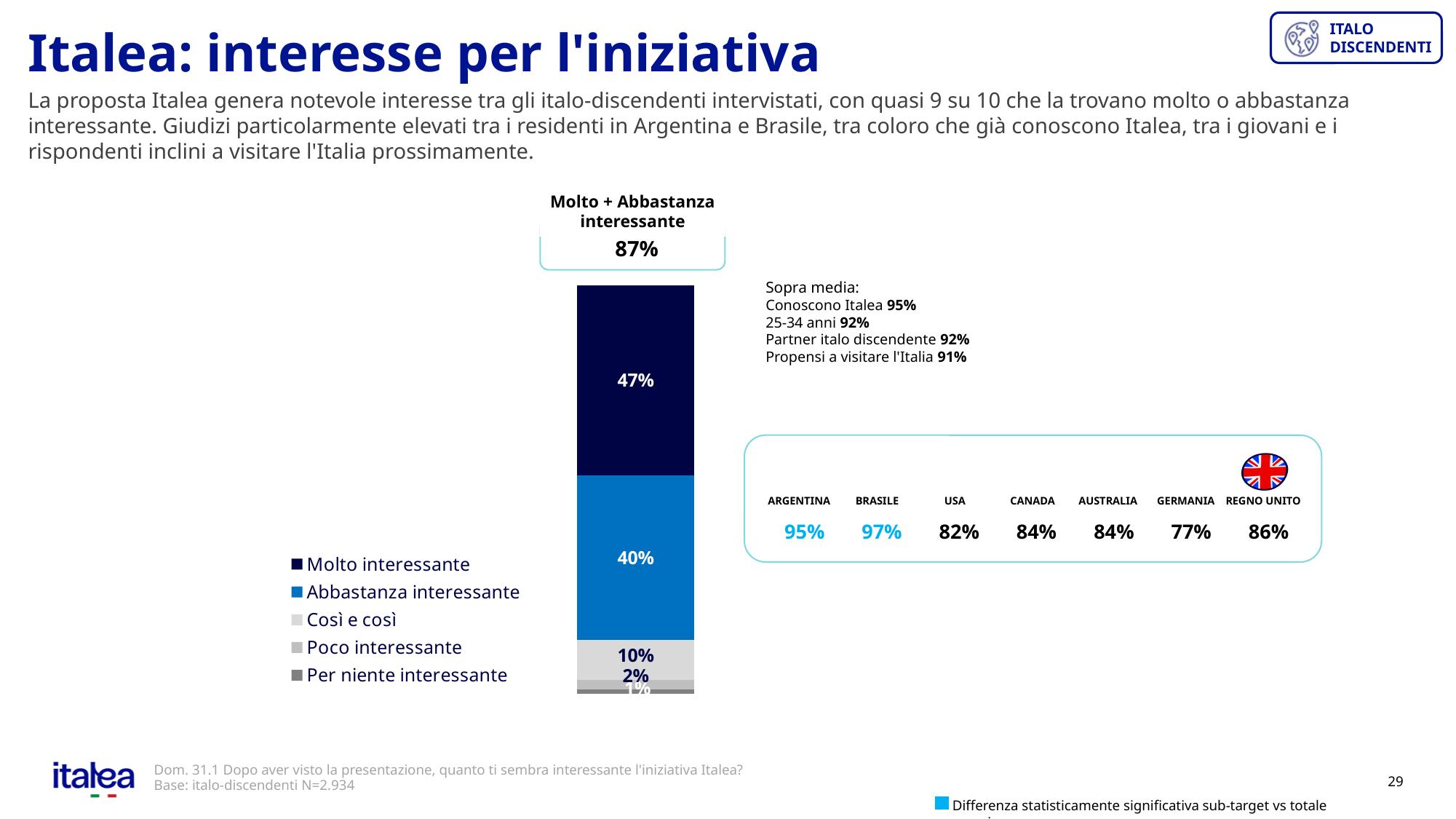
What is the combined total of "Molto interessante" and "Abbastanza interessante" as shown above the bar? 87% What percentage of respondents found the Italea initiative "Molto interessante"? 47% How many categories does the chart legend list? 5 What percentage is labelled for "Per niente interessante"? 1% What value does the chart show for "Poco interessante"? 2% What is the value shown for "Abbastanza interessante" in the stacked bar? 40% What is the difference in percentage points between "Molto interessante" and "Abbastanza interessante"? 7 percentage points Which response category has the largest segment in the stacked bar? Molto interessante What kind of chart is shown on the slide? Stacked bar chart Which is larger, the value for "Così e così" or the value for "Poco interessante"? Così e così What percentage is shown for "Così e così"? 10% Which response category has the smallest segment in the stacked bar? Per niente interessante